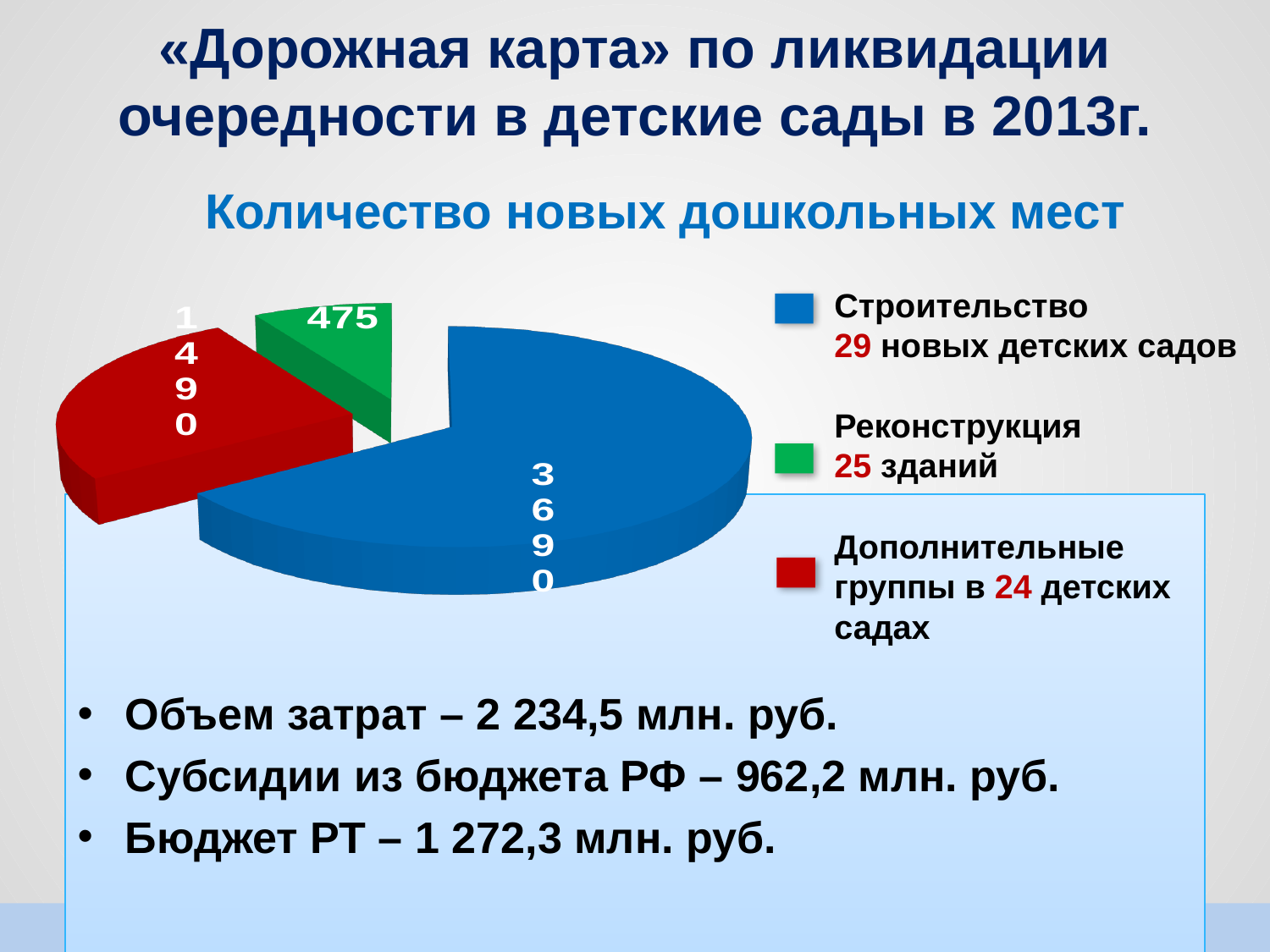
What is the total number of new preschool places across all three slices? 5655 Which is larger: the value for Дополнительные группы or the value for Реконструкция? Дополнительные группы What type of chart is shown on the slide? Pie chart What is the title of the chart on the slide? Количество новых дошкольных мест What value is shown for the red slice (Дополнительные группы в 24 детских садах)? 1490 What value is shown for the blue slice (Строительство 29 новых детских садов)? 3690 How many entries does the chart legend list? 3 What value is shown for the green slice (Реконструкция 25 зданий)? 475 Which category has the smallest number of new preschool places? Реконструкция 25 зданий Which category has the largest number of new preschool places? Строительство 29 новых детских садов How many slices does the pie chart have? 3 What is the difference between the values for Строительство (3690) and Дополнительные группы (1490)? 2200